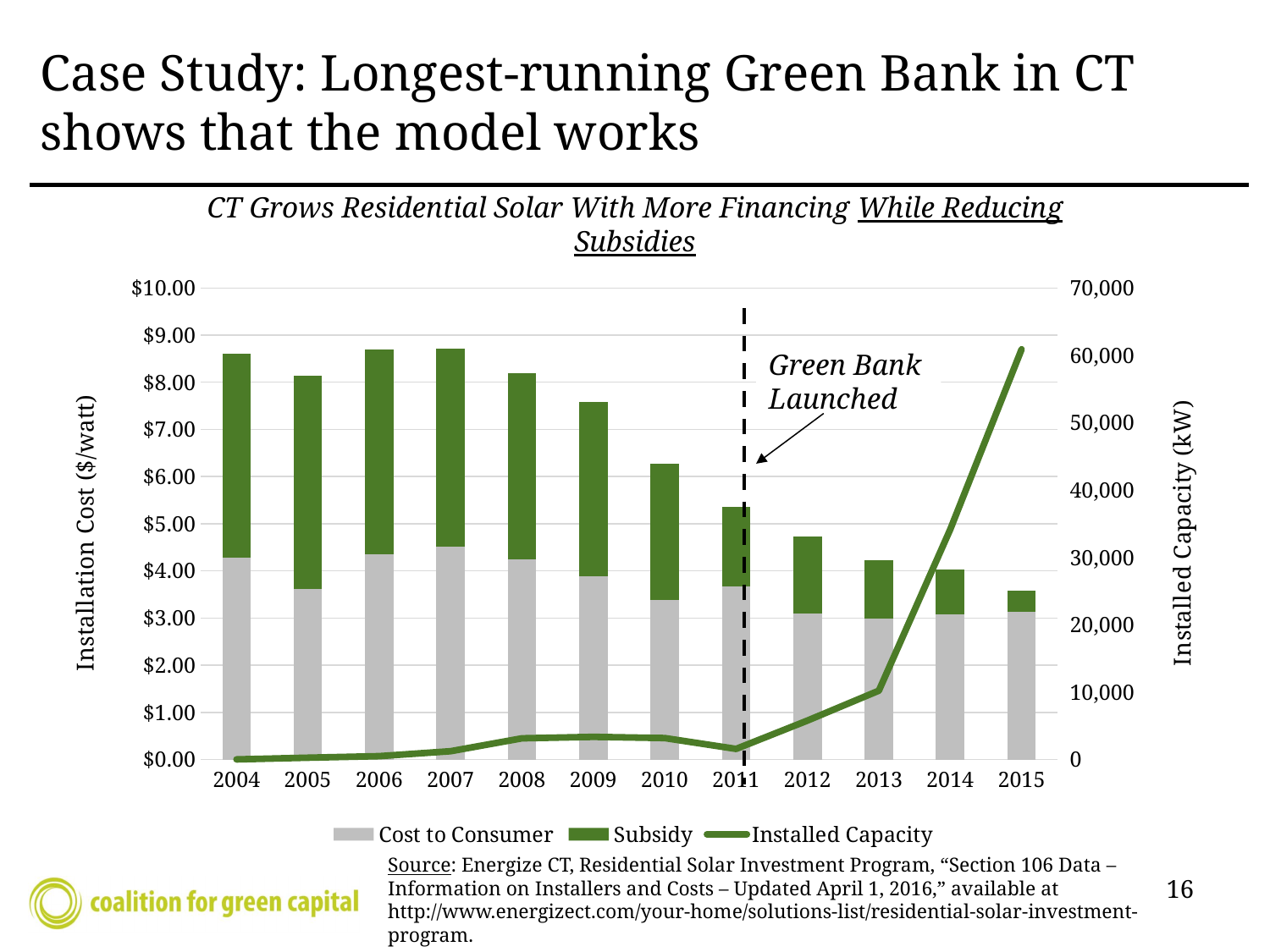
What kind of chart is shown on the slide? A combined stacked bar and line chart Which year has the smallest Subsidy segment? 2015 Which is larger, the total installation cost in 2004 or in 2015? 2004 Is the Installed Capacity for 2015 greater or less than 50,000 kW? greater How does the total installation cost change from 2004 to 2015? It falls According to the dashed line annotation, in which year was the Green Bank launched? 2011 Which year has the lowest total installation cost (Cost to Consumer plus Subsidy)? 2015 Is the total installation cost for 2015 greater or less than $4.00? less Is the total installation cost for 2004 greater or less than $8.00? greater How many series does the chart's legend list? 3 In which year is Installed Capacity highest? 2015 How many years are shown along the x axis of the chart? 12